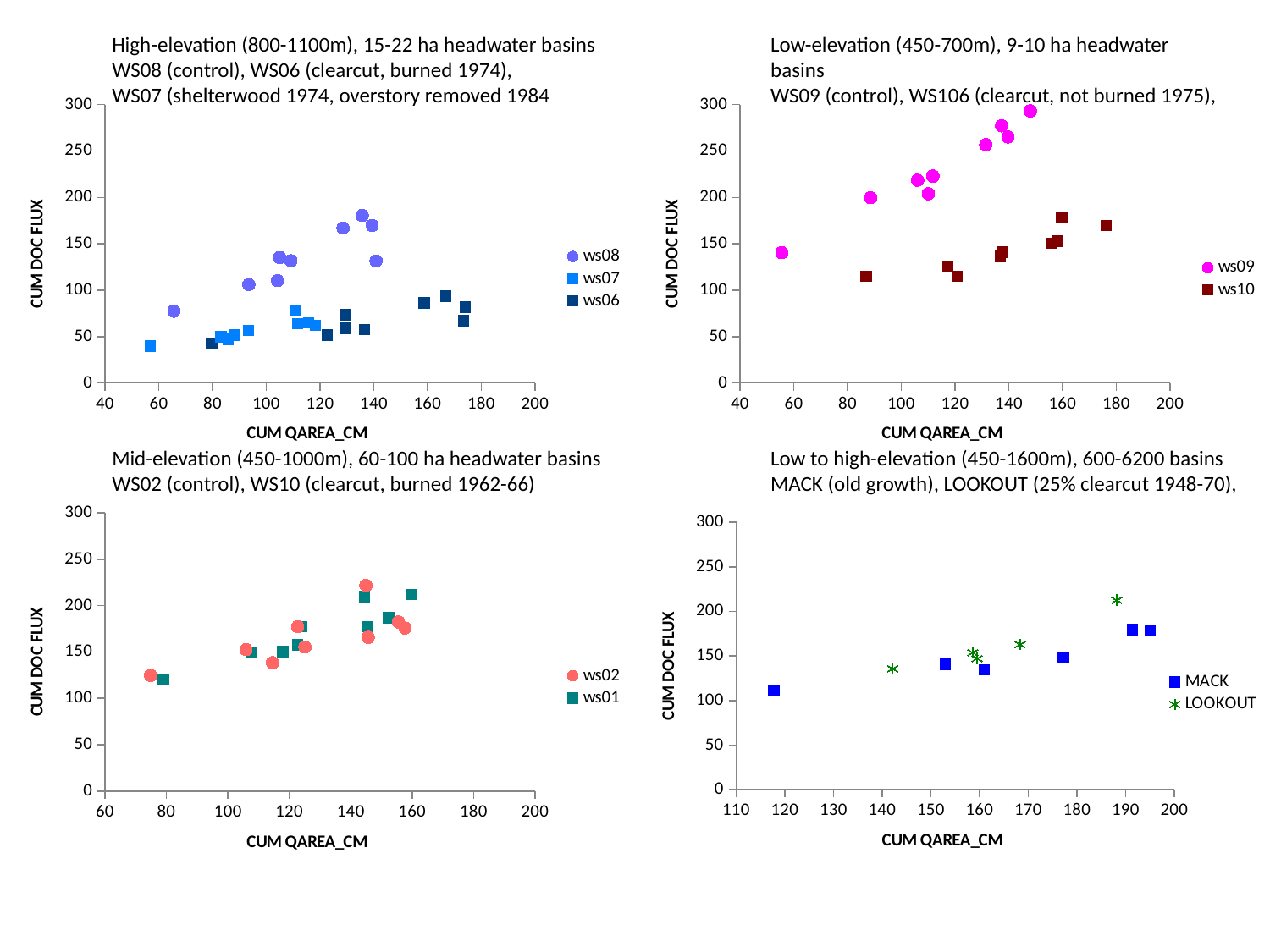
What are the two series listed in the legend of the bottom-right chart (Low to high-elevation basins)? MACK and LOOKOUT What is the y-axis title of the bottom-left chart (Mid-elevation basins)? CUM DOC FLUX In the top-left chart (High-elevation basins), do the ws08 values generally rise or fall as CUM QAREA_CM increases? rise How many series does the legend of the top-right chart (Low-elevation basins) list? 2 In the top-left chart (High-elevation basins), which series is plotted with the highest CUM DOC FLUX values overall: ws08 or ws06? ws08 In the top-right chart (Low-elevation basins), is the highest ws09 value greater or less than 250? greater In the bottom-left chart (Mid-elevation basins), is the lowest ws02 value greater or less than 100? greater In the top-right chart (Low-elevation basins), is the highest ws10 value greater or less than 200? less What kind of chart is the top-left chart (High-elevation basins)? scatter chart In the bottom-right chart (Low to high-elevation basins), do the MACK values generally rise or fall as CUM QAREA_CM increases? rise How many series does the legend of the top-left chart (High-elevation basins) list? 3